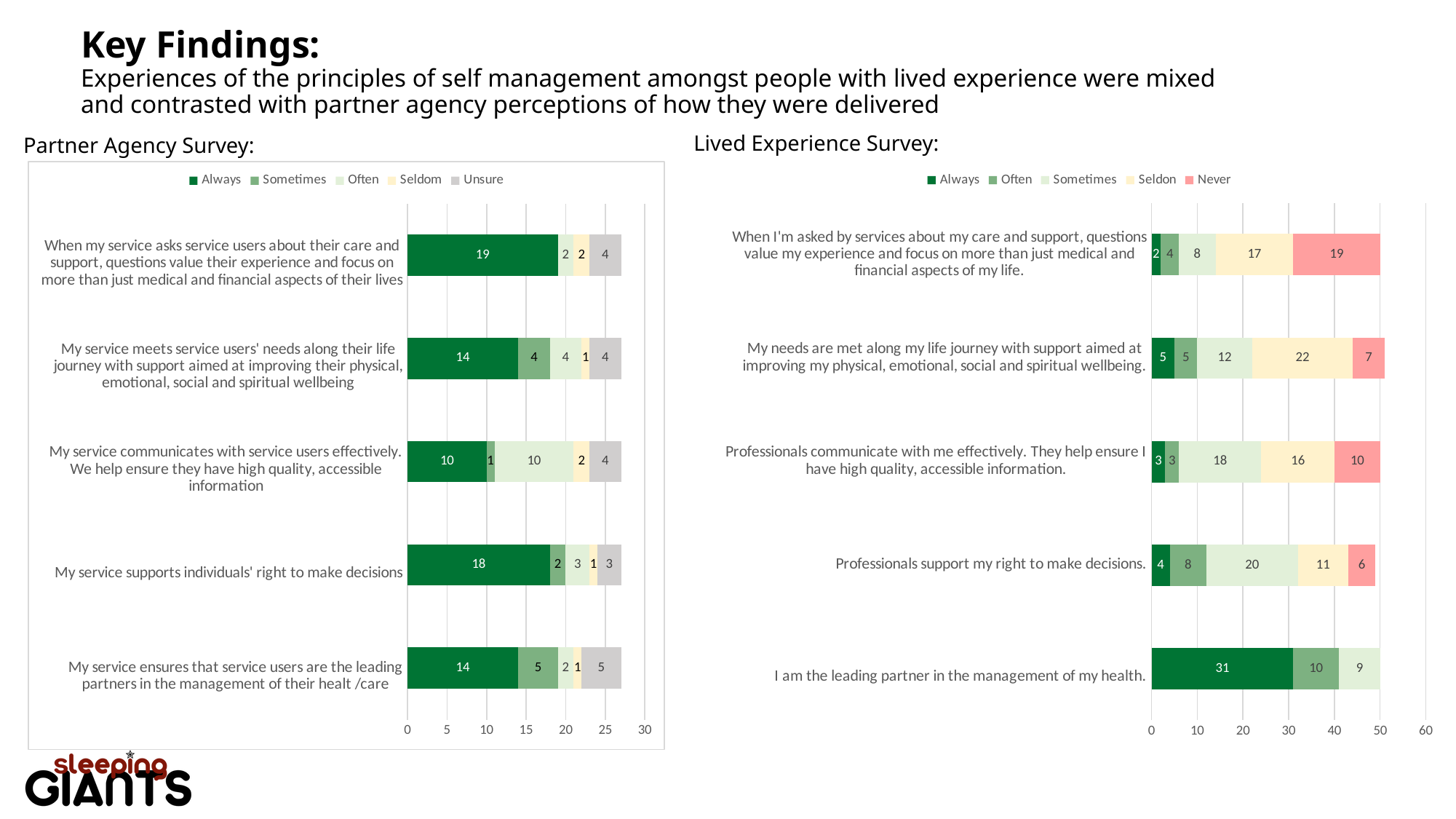
In the Lived Experience Survey chart, what is the Seldon value for "My needs are met along my life journey with support aimed at improving my physical, emotional, social and spiritual wellbeing."? 22 In the Partner Agency Survey chart, what is the total of the stacked bar for "My service ensures that service users are the leading partners in the management of their healt /care"? 27 How many series does the legend of the Partner Agency Survey chart list? 5 What kind of chart is the Lived Experience Survey chart? Stacked bar chart In the Partner Agency Survey chart, which is larger for "My service communicates with service users effectively. We help ensure they have high quality, accessible information": the Always value or the Unsure value? Always How many statements (categories) are plotted in the Lived Experience Survey chart? 5 In the Partner Agency Survey chart, which statement has the highest Always value? When my service asks service users about their care and support, questions value their experience and focus on more than just medical and financial aspects of their lives In the Partner Agency Survey chart, what is the Always value for "My service supports individuals' right to make decisions"? 18 In the Lived Experience Survey chart, what is the Never value for "When I'm asked by services about my care and support, questions value my experience and focus on more than just medical and financial aspects of my life."? 19 In the Lived Experience Survey chart, what is the difference between the Always value for "I am the leading partner in the management of my health." and the Always value for "Professionals support my right to make decisions."? 27 In the Lived Experience Survey chart, which statement has the lowest Always value? When I'm asked by services about my care and support, questions value my experience and focus on more than just medical and financial aspects of my life. In the Lived Experience Survey chart, what is the total of the stacked bar for "Professionals communicate with me effectively. They help ensure I have high quality, accessible information."? 50